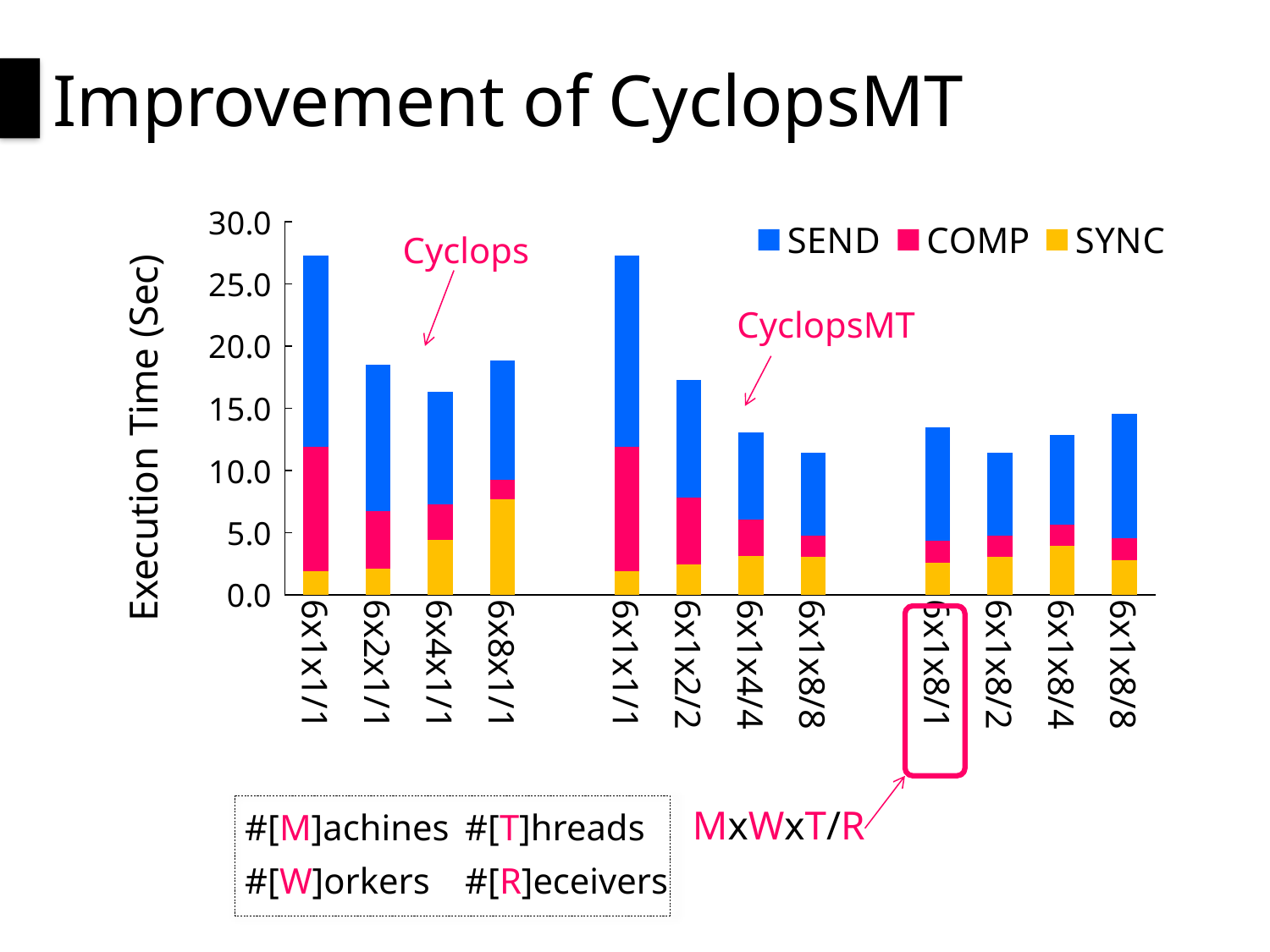
Which category label is highlighted with a box below the x axis? 6x1x8/1 How many bars are plotted in the chart? 12 What is the label of the y axis? Execution Time (Sec) How many series does the legend list? 3 Is the total execution time for the first 6x1x1/1 bar greater or less than 25.0? greater Is the SYNC segment for 6x8x1/1 greater or less than 5.0? greater Which has the larger total execution time, 6x2x1/1 or 6x4x1/1? 6x2x1/1 Is the total execution time for 6x2x1/1 greater or less than 20.0? less Which category label has the tallest bars in the chart? 6x1x1/1 What kind of chart is shown on the slide? stacked bar chart In the CyclopsMT group from 6x1x1/1 through 6x1x2/2 and 6x1x4/4 to 6x1x8/8, do the bar totals rise or fall? fall